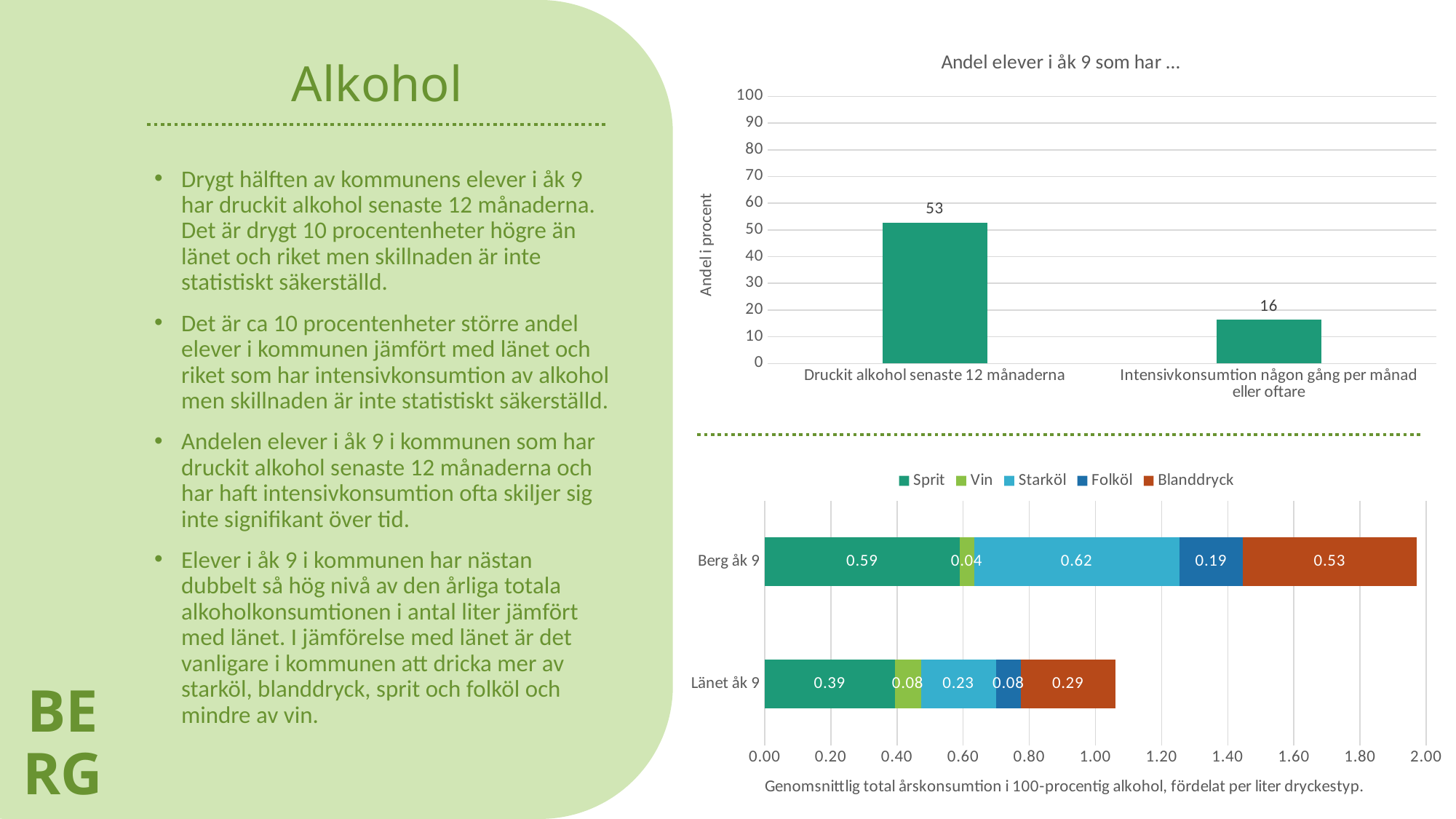
In the chart titled "Andel elever i åk 9 som har …", what is the label of the vertical axis? Andel i procent In the bottom chart, what is the total of the stacked bar for Länet åk 9? 1.07 In the chart titled "Andel elever i åk 9 som har …", what is the value for "Intensivkonsumtion någon gång per månad eller oftare"? 16 In the chart titled "Andel elever i åk 9 som har …", what is the value for "Druckit alkohol senaste 12 månaderna"? 53 What kind of chart is the bottom chart? Stacked bar chart In the chart titled "Andel elever i åk 9 som har …", how many categories are shown? 2 In the bottom chart, how many series does the legend list? 5 In the bottom chart, what is the total of the stacked bar for Berg åk 9? 1.97 In the chart titled "Andel elever i åk 9 som har …", what is the difference between the two bars? 37 In the bottom chart, what is the Blanddryck value for Länet åk 9? 0.29 In the bottom chart, what is the Starköl value for Berg åk 9? 0.62 In the bottom chart, which has the larger Vin value, Berg åk 9 or Länet åk 9? Länet åk 9